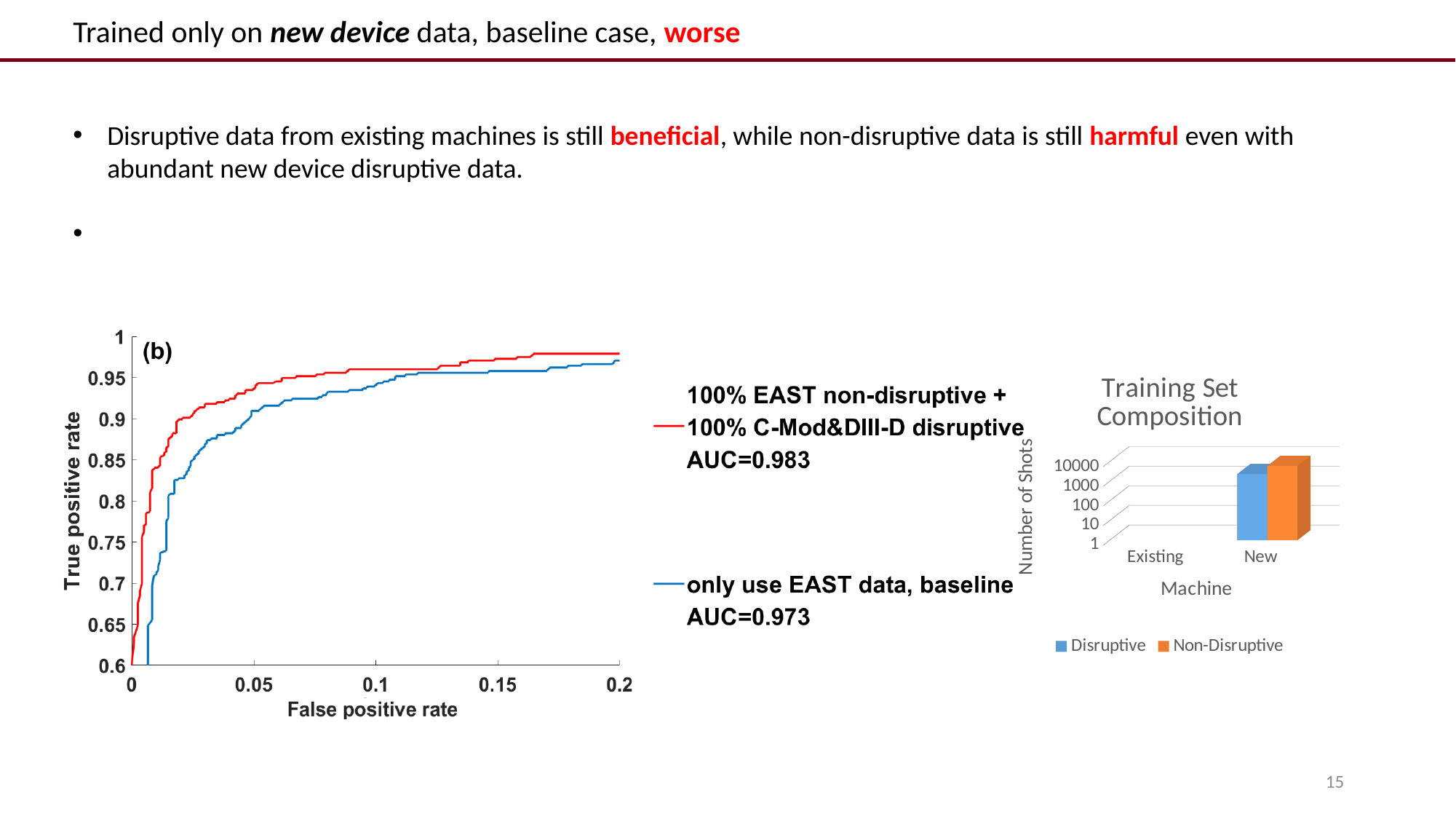
In the chart labelled (b), what is the largest value shown on the false positive rate axis? 0.2 What kind of chart is the chart labelled (b) on the left of the slide? line chart In the chart labelled (b), what is the AUC of the model that only uses EAST data (baseline)? 0.973 In the 'Training Set Composition' chart, is the number of Disruptive shots for the New machine greater or less than 1000? greater In the chart labelled (b), which curve has the higher AUC, the red one or the blue one? the red one In the chart labelled (b), what is the difference between the two AUC values shown? 0.01 In the 'Training Set Composition' chart, which series has the taller bar for the New machine, Disruptive or Non-Disruptive? Non-Disruptive In the chart labelled (b), does the true positive rate rise or fall as the false positive rate increases? rise In the chart labelled (b), what is the AUC of the model trained on 100% EAST non-disruptive + 100% C-Mod&DIII-D disruptive data? 0.983 How many machine categories are shown on the x axis of the 'Training Set Composition' chart? 2 How many series does the legend of the 'Training Set Composition' chart list? 2 What kind of chart is the 'Training Set Composition' chart? bar chart